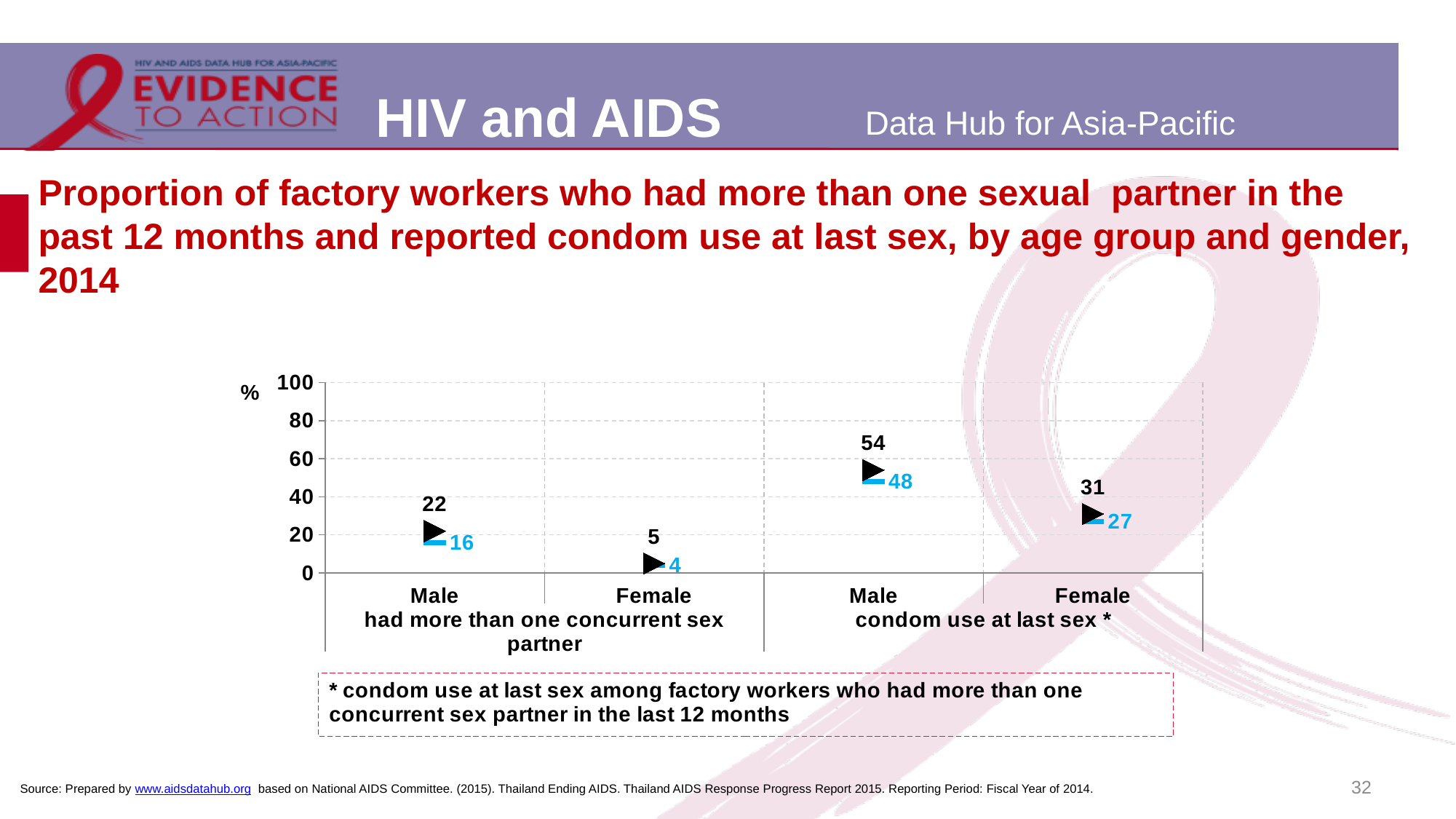
Which category has the lowest blue marker value? Female, had more than one concurrent sex partner What is the blue marker value for Female under 'condom use at last sex'? 27 Which category has the highest black triangle marker value? Male, condom use at last sex What is the black triangle marker value for Male under 'condom use at last sex'? 54 How many categories are shown on the x axis? 4 What is the black triangle marker value for Male under 'had more than one concurrent sex partner'? 22 What unit is shown on the y axis of the chart? % What is the difference between the black triangle and blue marker values for Male under 'condom use at last sex'? 6 Which is larger: the blue marker value for Male under 'condom use at last sex' or the blue marker value for Female under 'condom use at last sex'? Male Is the black triangle marker value for Female under 'condom use at last sex' greater or less than 40? less What is the blue marker value for Female under 'had more than one concurrent sex partner'? 4 What is the difference between the black triangle marker values for Male and Female under 'had more than one concurrent sex partner'? 17